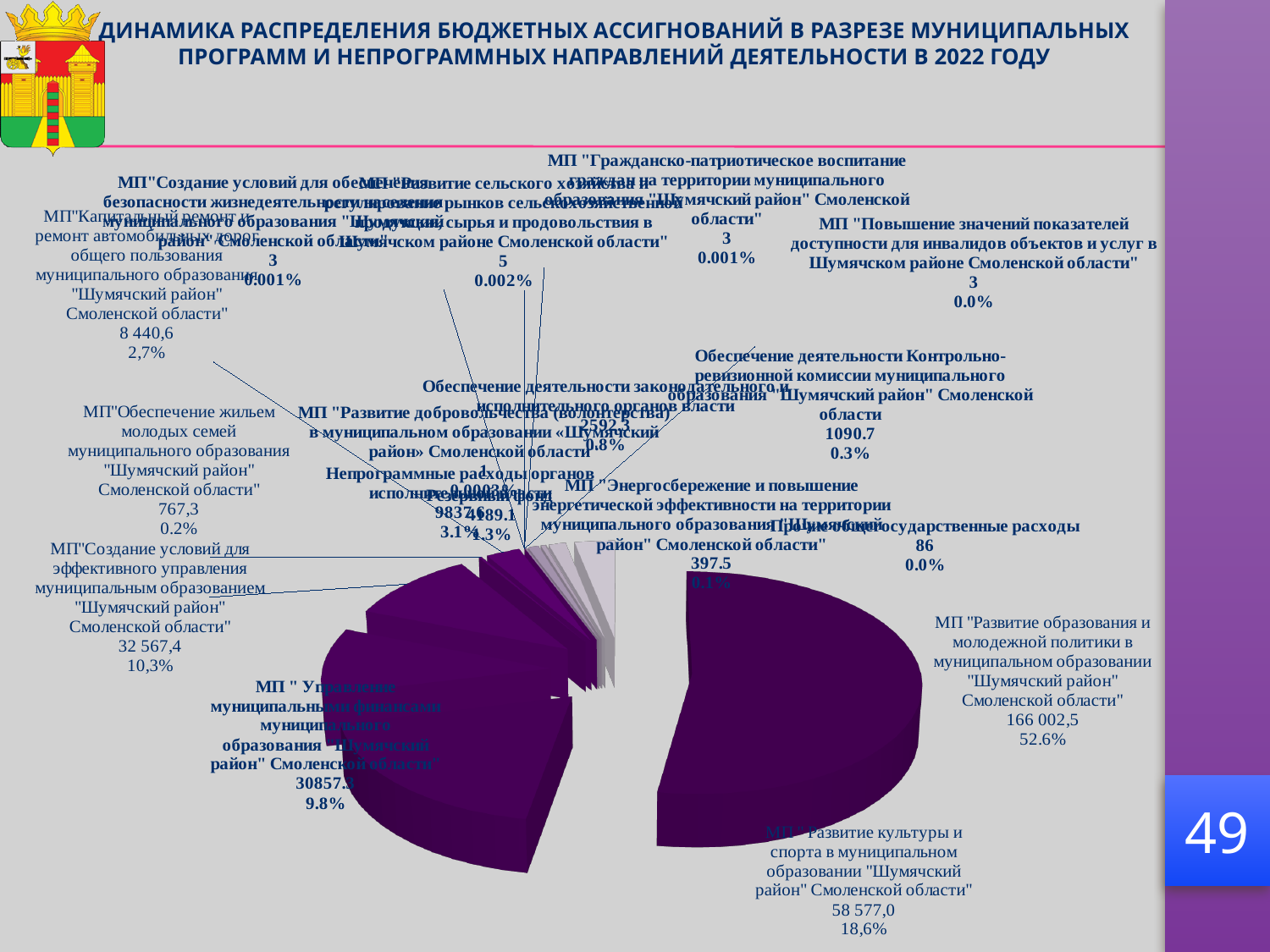
What is the value for МП "Обеспечение жильем молодых семей муниципального образования "Шумячский район" Смоленской области"? 767,3 What is the value for МП "Развитие культуры и спорта в муниципальном образовании "Шумячский район" Смоленской области"? 58 577,0 What kind of chart is shown on the slide? pie chart What is the value for МП "Создание условий для эффективного управления муниципальным образованием "Шумячский район" Смоленской области"? 32 567,4 What share of the pie does МП "Капитальный ремонт и ремонт автомобильных дорог общего пользования" account for? 2,7% Which category has the largest slice of the pie? МП "Развитие образования и молодежной политики в муниципальном образовании "Шумячский район" Смоленской области" What share of the pie does МП "Развитие культуры и спорта" account for? 18,6% What share of the pie does МП "Развитие образования и молодежной политики" account for? 52.6% Which is larger: the value for МП "Развитие культуры и спорта" or the value for МП "Создание условий для эффективного управления муниципальным образованием"? МП "Развитие культуры и спорта" What is the difference between the value for МП "Развитие культуры и спорта" (58 577,0) and the value for МП "Создание условий для эффективного управления муниципальным образованием" (32 567,4)? 26 009,6 What is the value for Обеспечение деятельности Контрольно-ревизионной комиссии муниципального образования "Шумячский район" Смоленской области? 1090.7 What is the value for МП "Развитие образования и молодежной политики в муниципальном образовании "Шумячский район" Смоленской области"? 166 002,5